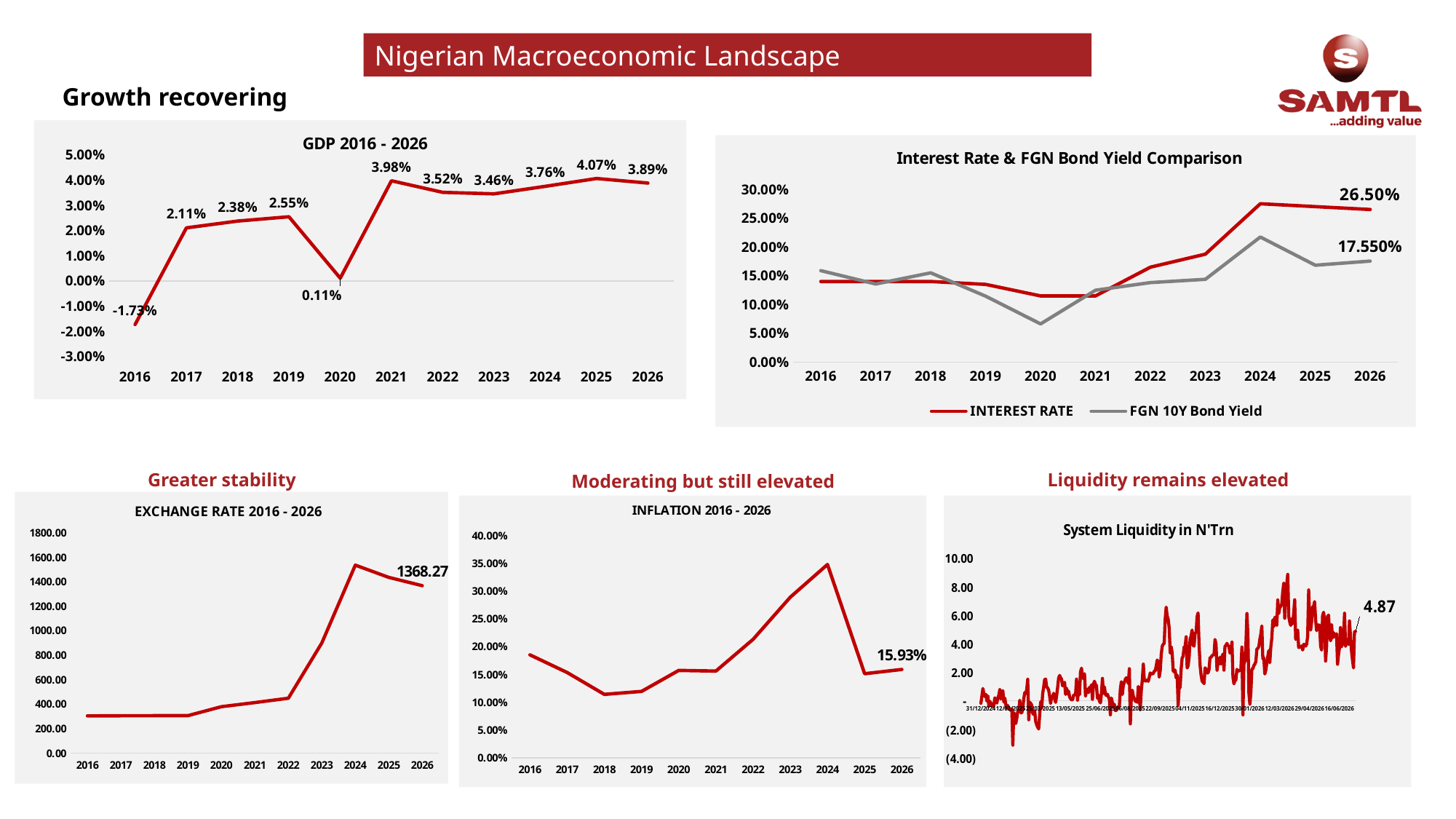
In the GDP 2016 - 2026 chart, what is the GDP growth value for 2020? 0.11% In the GDP 2016 - 2026 chart, what is the difference between the 2025 and 2026 values? 0.18% How many years are plotted on the x axis of the GDP 2016 - 2026 chart? 11 In the INFLATION 2016 - 2026 chart, which year has the highest inflation value? 2024 In the GDP 2016 - 2026 chart, which year has the larger value, 2021 or 2022? 2021 In the EXCHANGE RATE 2016 - 2026 chart, what is the value labelled for 2026? 1368.27 In the GDP 2016 - 2026 chart, which year has the highest GDP growth value? 2025 In the Interest Rate & FGN Bond Yield Comparison chart, what is the interest rate value labelled for 2026? 26.50% In the GDP 2016 - 2026 chart, which year has the lowest GDP growth value? 2016 In the Interest Rate & FGN Bond Yield Comparison chart, what is the FGN 10Y Bond Yield value labelled for 2026? 17.550% In the Interest Rate & FGN Bond Yield Comparison chart, is the interest rate for 2024 greater or less than 25.00%? greater How many series does the legend of the Interest Rate & FGN Bond Yield Comparison chart list? 2